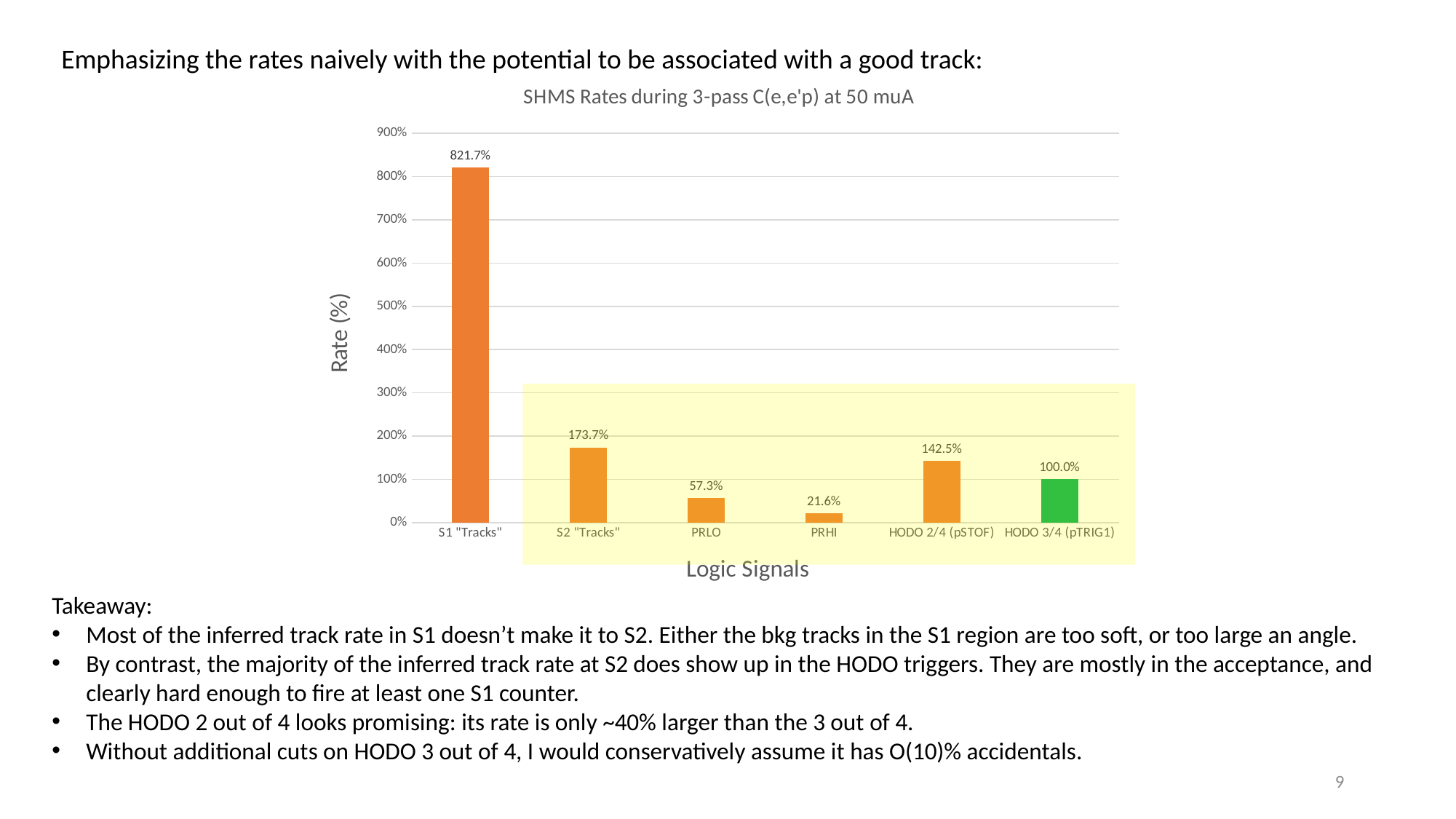
Which has a larger rate, PRLO or HODO 3/4 (pTRIG1)? HODO 3/4 (pTRIG1) Which logic signal has the highest rate? S1 "Tracks" What is the value for S1 "Tracks"? 821.7% How many logic signals are shown on the x axis? 6 What is the value for PRHI? 21.6% What kind of chart is shown on the slide? bar chart Is the value for S2 "Tracks" greater or less than 200%? less What is the value for HODO 2/4 (pSTOF)? 142.5% Which bar is coloured green rather than orange? HODO 3/4 (pTRIG1) What is the difference between the rates for S2 "Tracks" and HODO 2/4 (pSTOF)? 31.2% Which logic signal has the lowest rate? PRHI What is the title of the chart? SHMS Rates during 3-pass C(e,e'p) at 50 muA